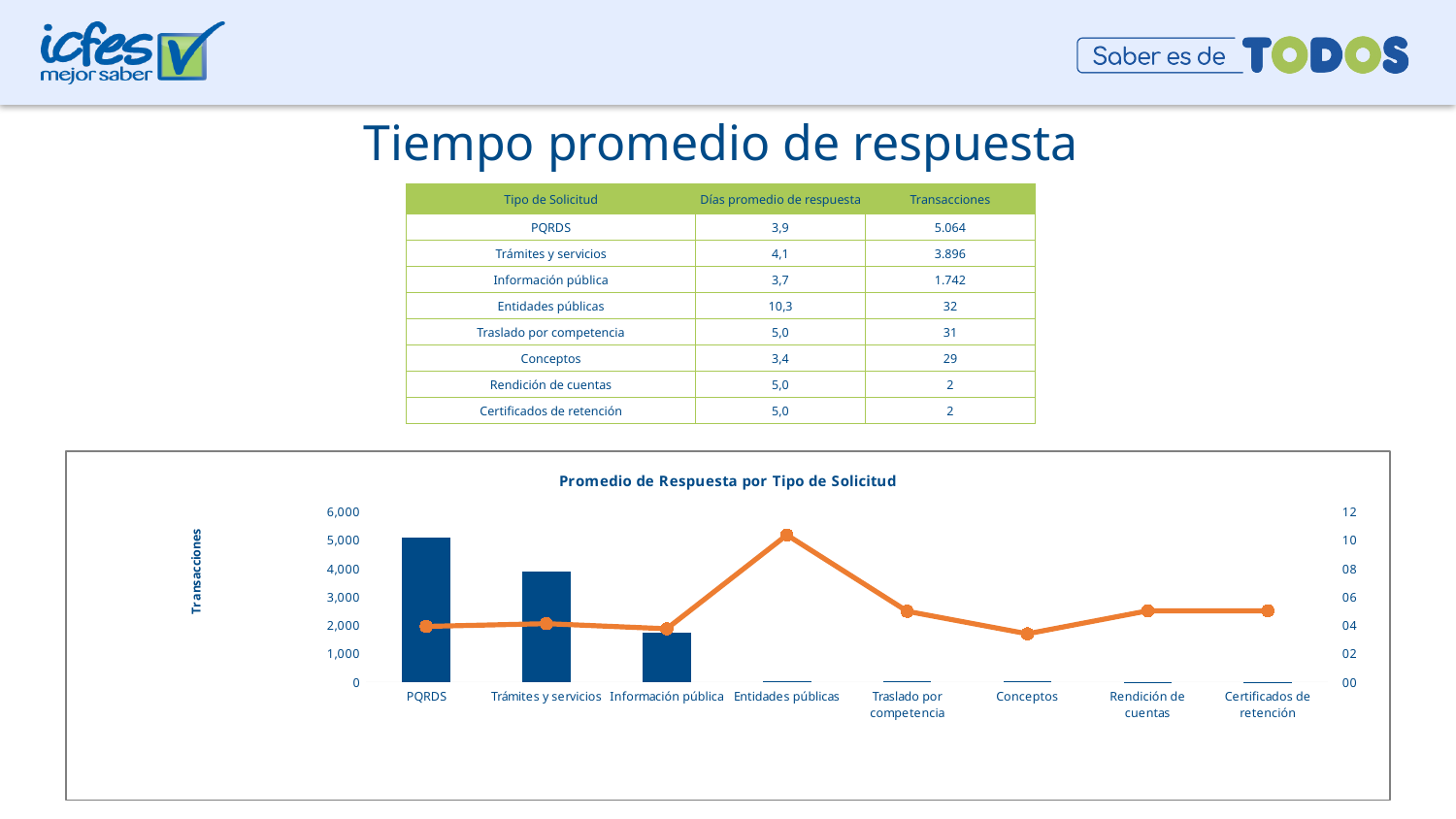
Which category has the tallest bar (most transactions) in the chart? PQRDS Which has the taller bar, Trámites y servicios or Información pública? Trámites y servicios How many request types (categories) are shown along the x axis of the chart? 8 Is the line point for Entidades públicas greater or less than 08 on the right axis? greater What is the difference in transactions between PQRDS and Trámites y servicios? 1.168 How many transactions are plotted for Trámites y servicios? 3.896 What is the average response time in days plotted for Entidades públicas? 10,3 Which category has the highest point on the line (longest average response time) in the chart? Entidades públicas Is the bar for PQRDS greater or less than 4,000 transactions? greater Is the bar for Información pública greater or less than 2,000 transactions? less What is the title of the chart? Promedio de Respuesta por Tipo de Solicitud What kind of chart is shown on the slide? A combined bar and line chart